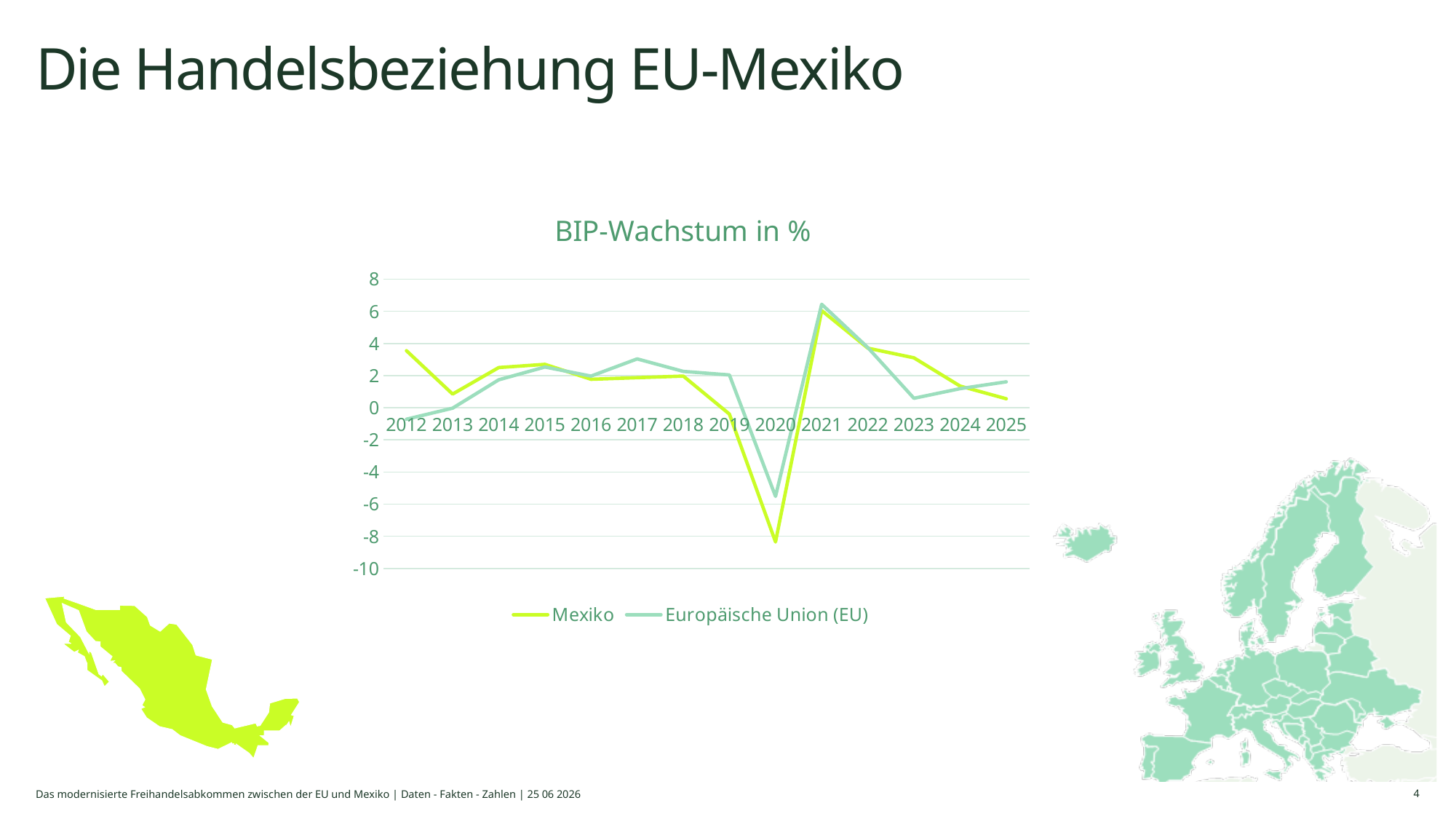
What is the title of the chart? BIP-Wachstum in % How many years are shown on the x axis? 14 In which year does the Mexiko series reach its lowest value? 2020 In 2020, which series has the larger value, Mexiko or Europäische Union (EU)? Europäische Union (EU) In which year does the Europäische Union (EU) series reach its highest value? 2021 Is the value for Europäische Union (EU) in 2020 greater or less than -4? less Is the value for Europäische Union (EU) in 2023 greater or less than 2? less Does the Mexiko series rise or fall from 2021 to 2025? fall How many series does the legend list? 2 Is the value for Mexiko in 2020 greater or less than -6? less What kind of chart is shown on the slide? line chart